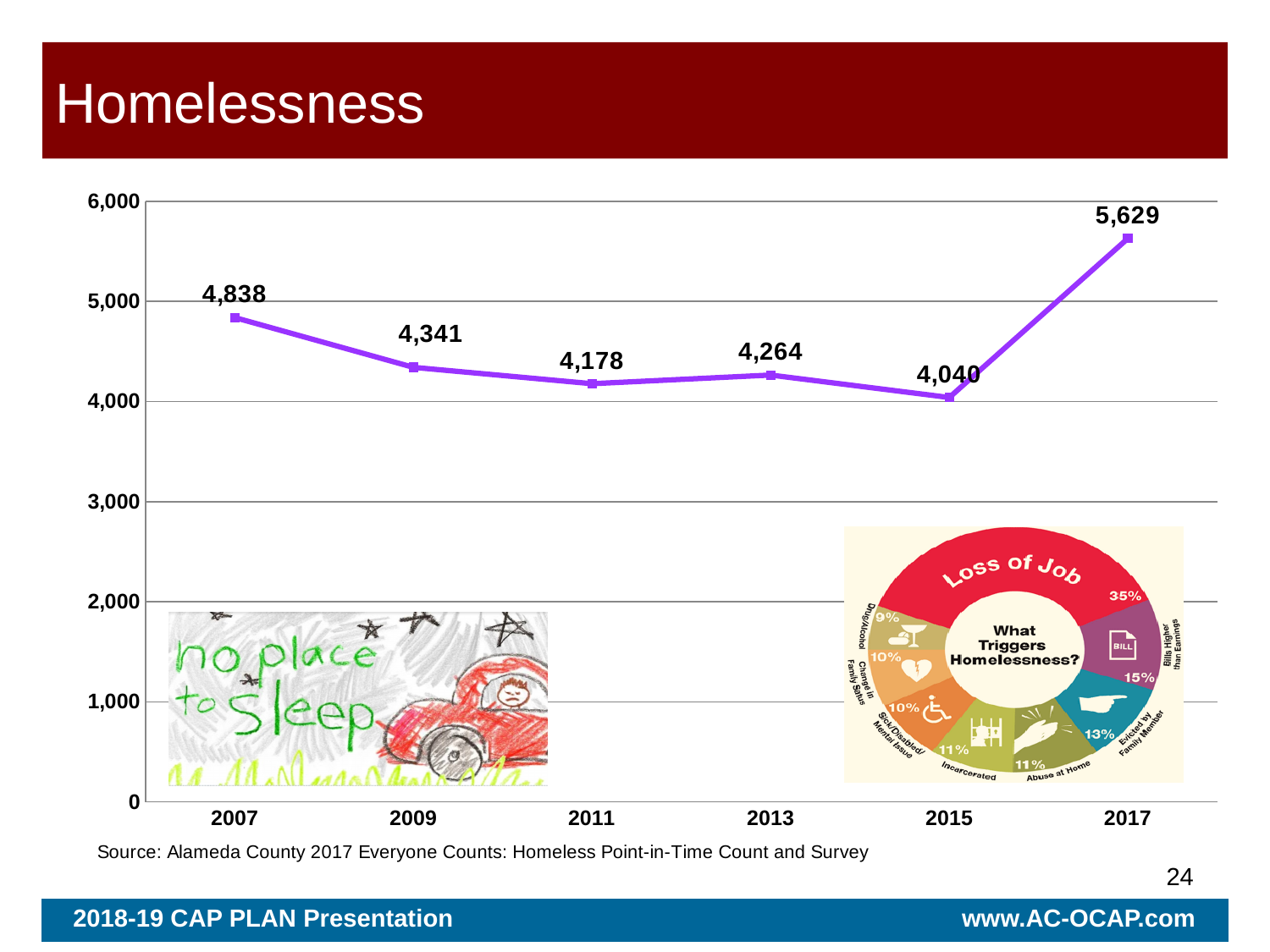
On the line chart, what is the difference between the 2007 value and the 2009 value? 497 On the line chart, what is the value for 2015? 4,040 On the 'What Triggers Homelessness?' donut chart, what share is shown for Loss of Job? 35% What kind of chart is the large chart on the slide? line chart On the line chart, what is the difference between the 2017 value and the 2015 value? 1,589 On the line chart, which year has the highest value? 2017 On the line chart, which is larger, the value for 2013 or the value for 2011? 2013 On the line chart, does the value rise or fall from 2015 to 2017? rise On the line chart, how many years are plotted? 6 On the line chart, which year has the lowest value? 2015 On the line chart, what is the value for 2017? 5,629 On the line chart, what is the value for 2007? 4,838